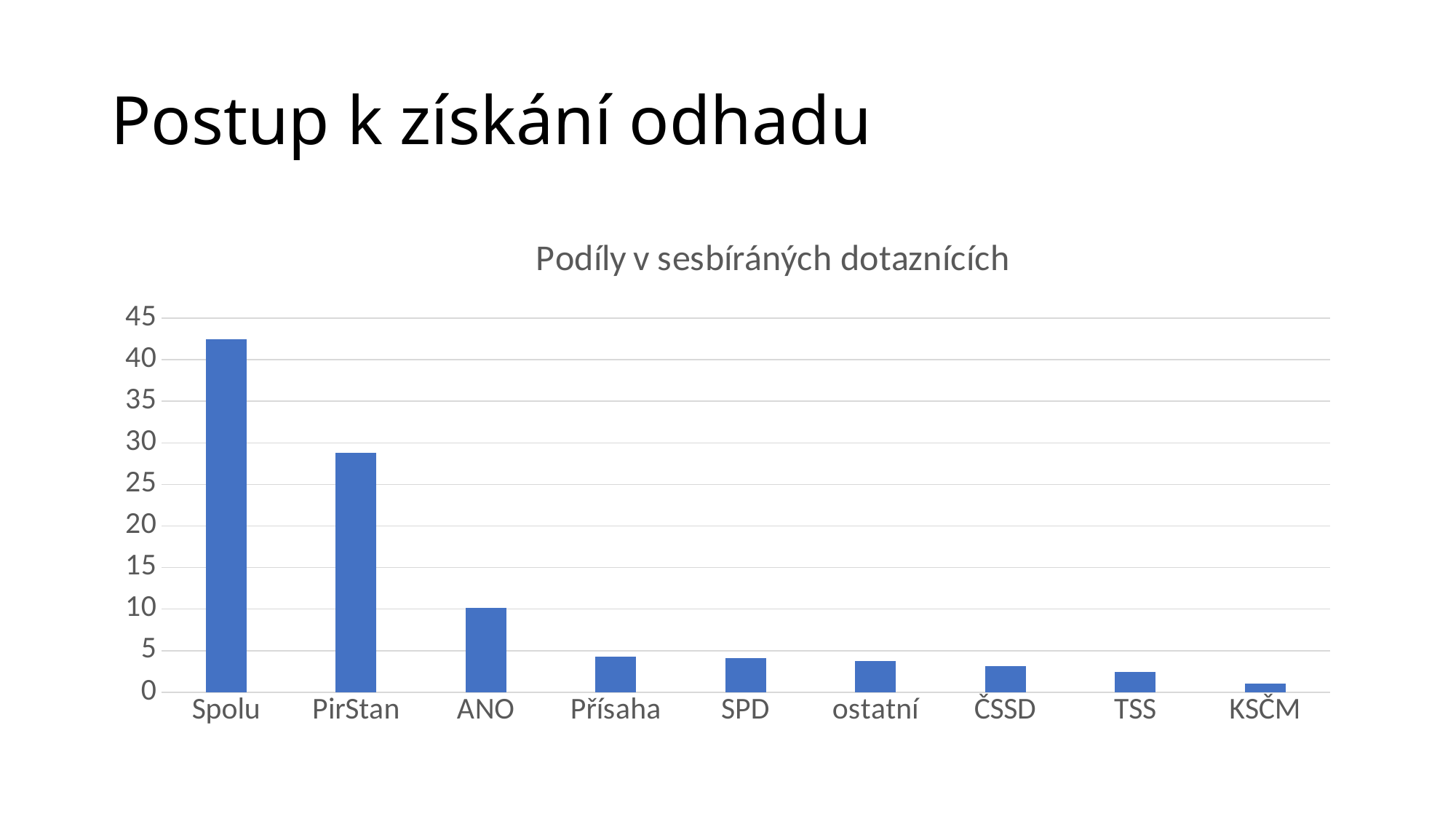
Which has a larger value, Spolu or PirStan? Spolu Do the values rise or fall from left to right along the x axis? fall Is the value for ANO greater or less than 15? less Which has a larger value, ANO or Přísaha? ANO Which category has the highest value in the chart? Spolu Is the value for KSČM greater or less than 5? less What is the title of the chart? Podíly v sesbíráných dotaznících Is the value for Spolu greater or less than 40? greater How many categories are shown on the x axis of the chart? 9 What kind of chart is shown on the slide? bar chart Which category has the lowest value in the chart? KSČM